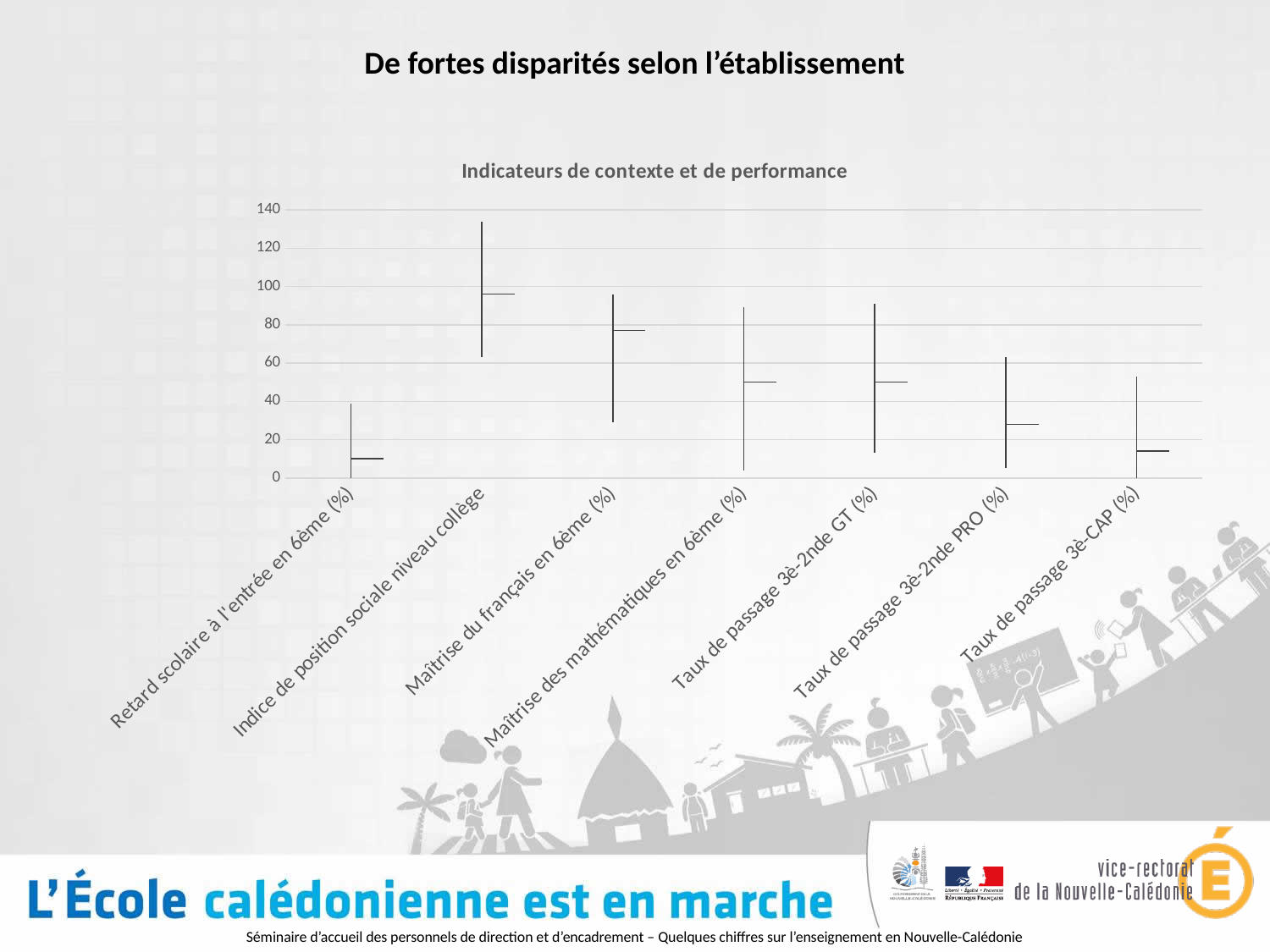
Is the marker value for 'Maîtrise du français en 6ème (%)' greater or less than 60? greater What is the title of the chart? Indicateurs de contexte et de performance Which category has the highest marker value in the chart? Indice de position sociale niveau collège Which category's range reaches the highest point in the chart? Indice de position sociale niveau collège What is the highest value shown on the vertical axis of the chart? 140 Is the marker value for 'Retard scolaire à l'entrée en 6ème (%)' greater or less than 20? less Is the marker value for 'Taux de passage 3è-2nde PRO (%)' greater or less than 20? greater Which has the larger marker value: 'Indice de position sociale niveau collège' or 'Taux de passage 3è-2nde GT (%)'? Indice de position sociale niveau collège What kind of chart is shown on the slide? high-low line (stock) chart How many categories are shown on the x axis of the chart? 7